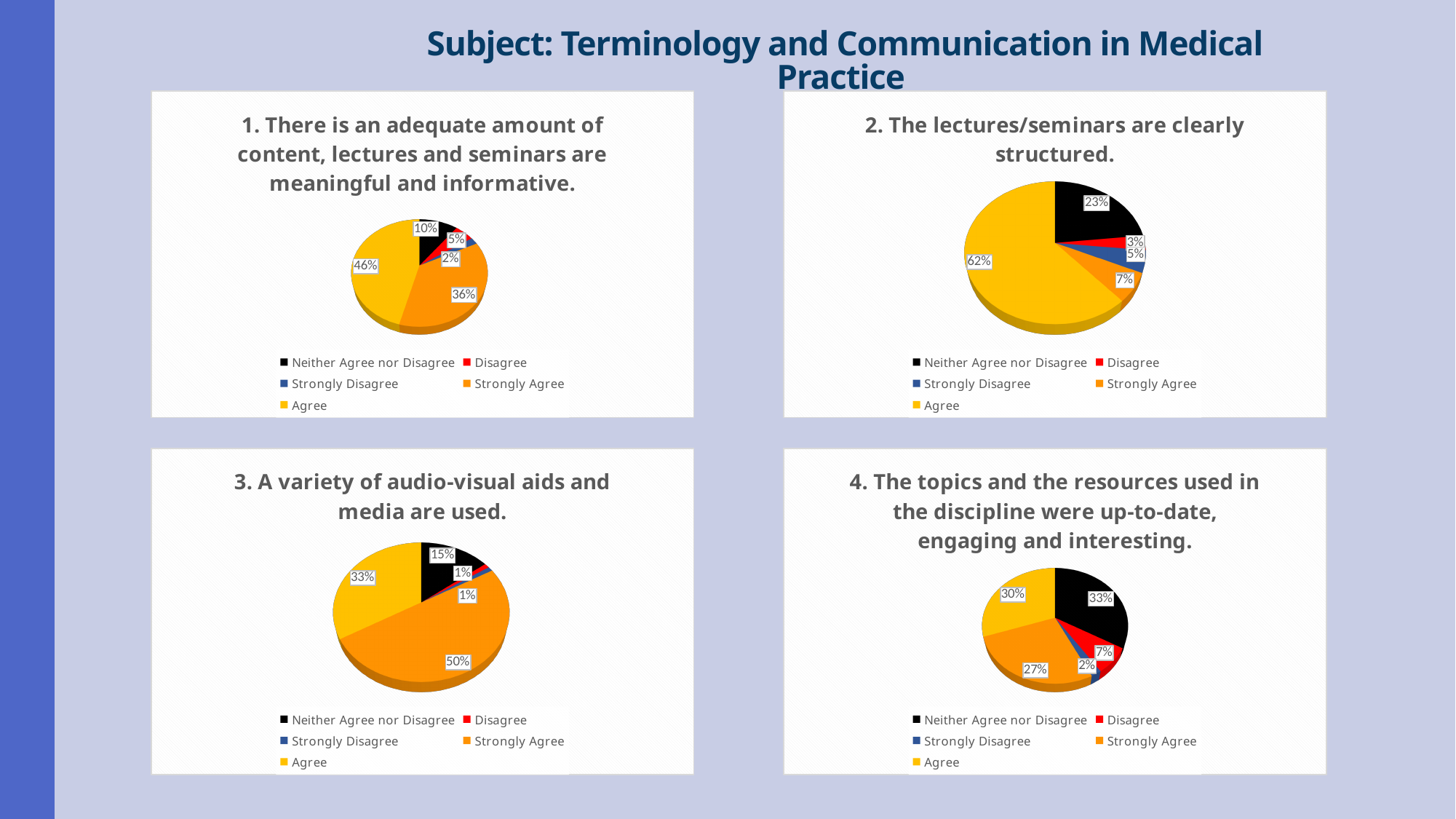
In the chart titled "4. The topics and the resources used in the discipline were up-to-date, engaging and interesting.", which is larger, Agree or Strongly Agree? Agree What type of chart is used in the chart titled "1. There is an adequate amount of content, lectures and seminars are meaningful and informative."? Pie chart In the chart titled "2. The lectures/seminars are clearly structured.", which category has the smallest slice? Disagree How many categories does the legend list in the chart titled "3. A variety of audio-visual aids and media are used."? 5 In the chart titled "3. A variety of audio-visual aids and media are used.", what percentage is shown for Strongly Agree? 50% In the chart titled "2. The lectures/seminars are clearly structured.", which category has the largest slice? Agree In the chart titled "3. A variety of audio-visual aids and media are used.", what is the difference between the Strongly Agree and Agree percentages? 17% In the chart titled "4. The topics and the resources used in the discipline were up-to-date, engaging and interesting.", what percentage is shown for Neither Agree nor Disagree? 33% In the chart titled "1. There is an adequate amount of content, lectures and seminars are meaningful and informative.", what share of the pie is Agree? 46% In the chart titled "1. There is an adequate amount of content, lectures and seminars are meaningful and informative.", what percentage is shown for Strongly Agree? 36% In the chart titled "4. The topics and the resources used in the discipline were up-to-date, engaging and interesting.", what percentage is shown for Strongly Disagree? 2% In the chart titled "2. The lectures/seminars are clearly structured.", what percentage is shown for Neither Agree nor Disagree? 23%